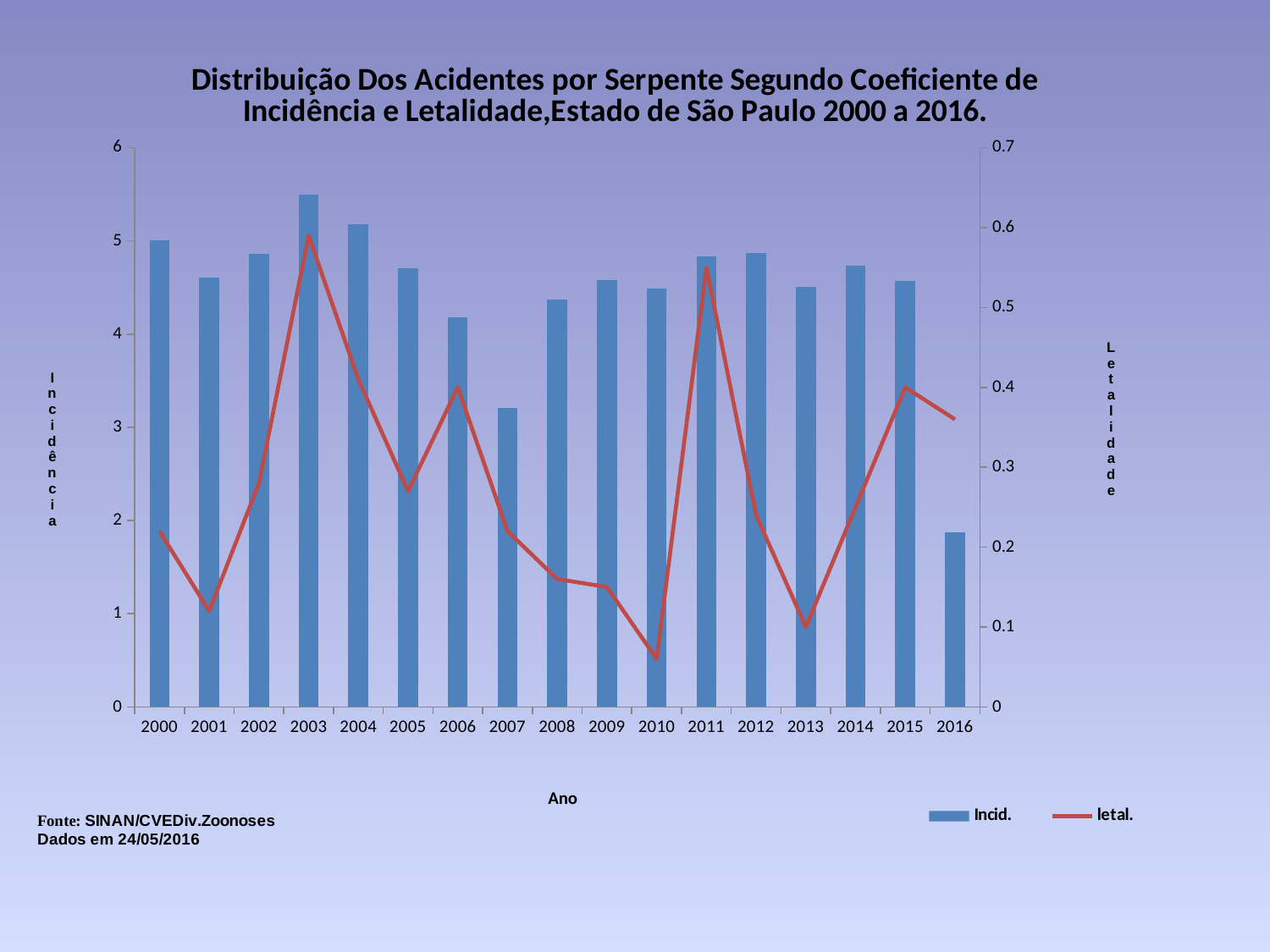
In which year does the letal. line reach its highest point? 2003 Is the letal. value for 2010 greater or less than 0.1? less Which year has the larger Incid. bar, 2003 or 2016? 2003 Is the Incid. value for 2007 greater or less than 3? greater What is the title of the x axis of the chart? Ano What kind of chart is shown on the slide? A combination bar and line chart How many series does the chart's legend list? 2 How many years are shown along the x axis of the chart? 17 In which year does the letal. line reach its lowest point? 2010 Which year has the lowest Incid. bar? 2016 Which year has the highest Incid. bar? 2003 Is the Incid. value for 2003 greater or less than 5? greater